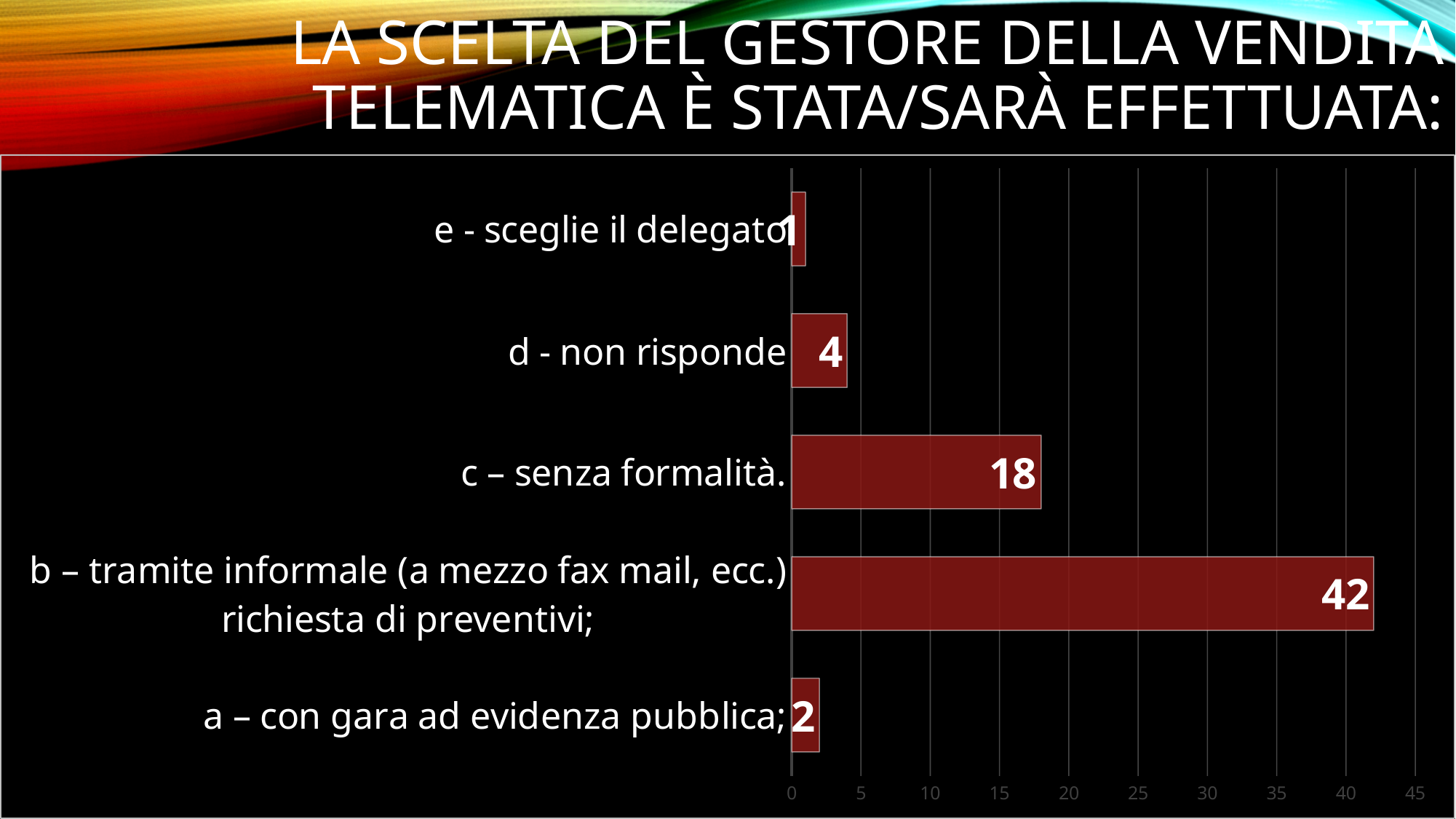
What kind of chart is shown on the slide? bar chart What is the value for "d - non risponde"? 4 Which category has the highest value? b – tramite informale (a mezzo fax mail, ecc.) richiesta di preventivi; What is the value for "b – tramite informale (a mezzo fax mail, ecc.) richiesta di preventivi;"? 42 What is the difference between the values for "b – tramite informale" and "c – senza formalità."? 24 Which is larger, the value for "d - non risponde" or the value for "a – con gara ad evidenza pubblica;"? d - non risponde What is the value for "a – con gara ad evidenza pubblica;"? 2 What is the value for "c – senza formalità."? 18 What is the highest tick value shown on the horizontal axis? 45 Which category has the lowest value? e - sceglie il delegato Is the value for "c – senza formalità." greater or less than 20? less How many categories are shown in the chart? 5